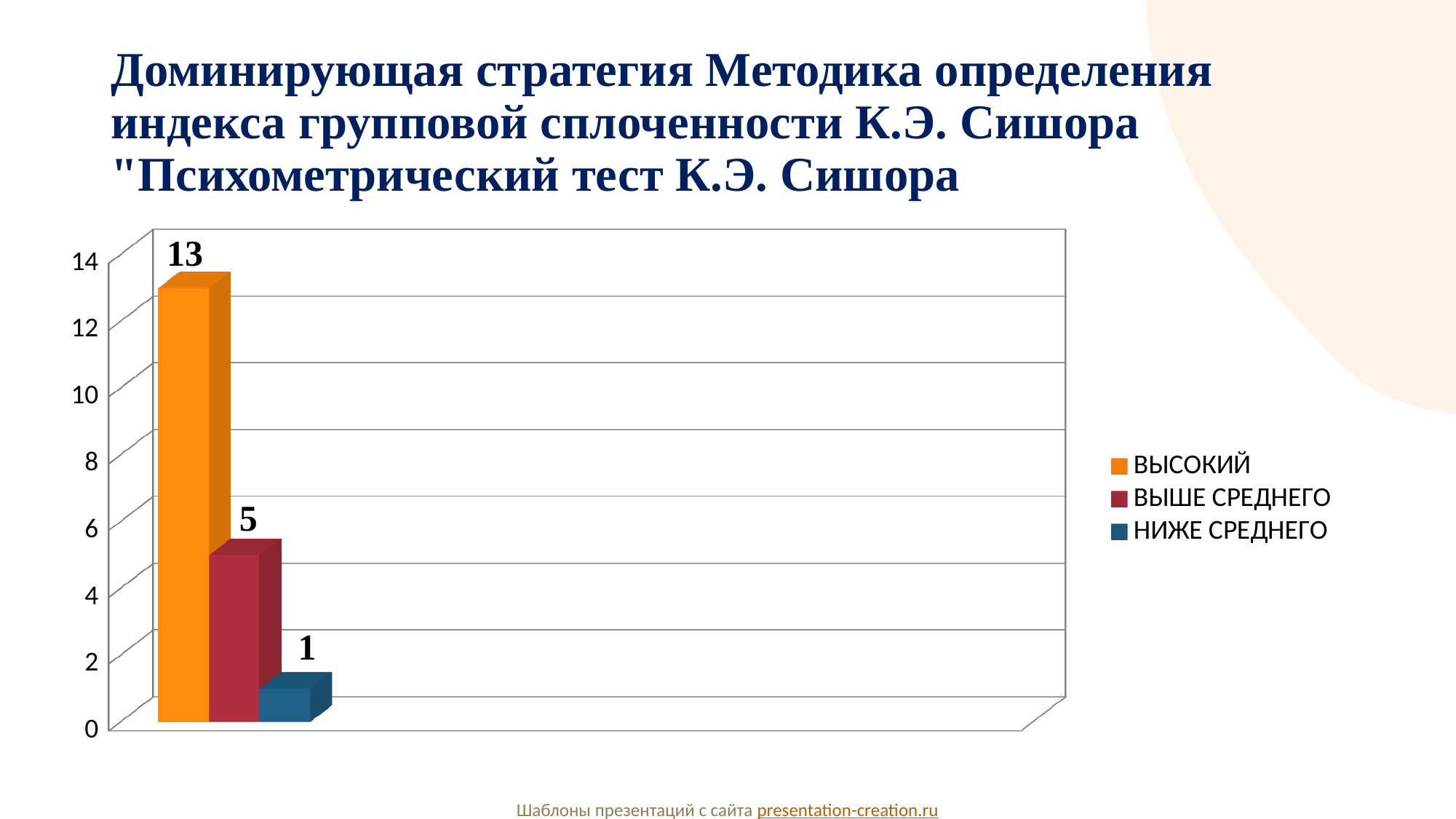
Which series has the lowest value? НИЖЕ СРЕДНЕГО Is the value for ВЫСОКИЙ greater or less than 10? greater How many series does the legend list? 3 What kind of chart is shown on the slide? bar chart What is the value for ВЫШЕ СРЕДНЕГО? 5 What colour is the bar for ВЫСОКИЙ? orange What is the value for НИЖЕ СРЕДНЕГО? 1 Which series has the highest value? ВЫСОКИЙ What is the difference between the values for ВЫСОКИЙ and ВЫШЕ СРЕДНЕГО? 8 What is the difference between the values for ВЫШЕ СРЕДНЕГО and НИЖЕ СРЕДНЕГО? 4 What is the value for ВЫСОКИЙ? 13 Which is larger, the value for ВЫШЕ СРЕДНЕГО or the value for НИЖЕ СРЕДНЕГО? ВЫШЕ СРЕДНЕГО